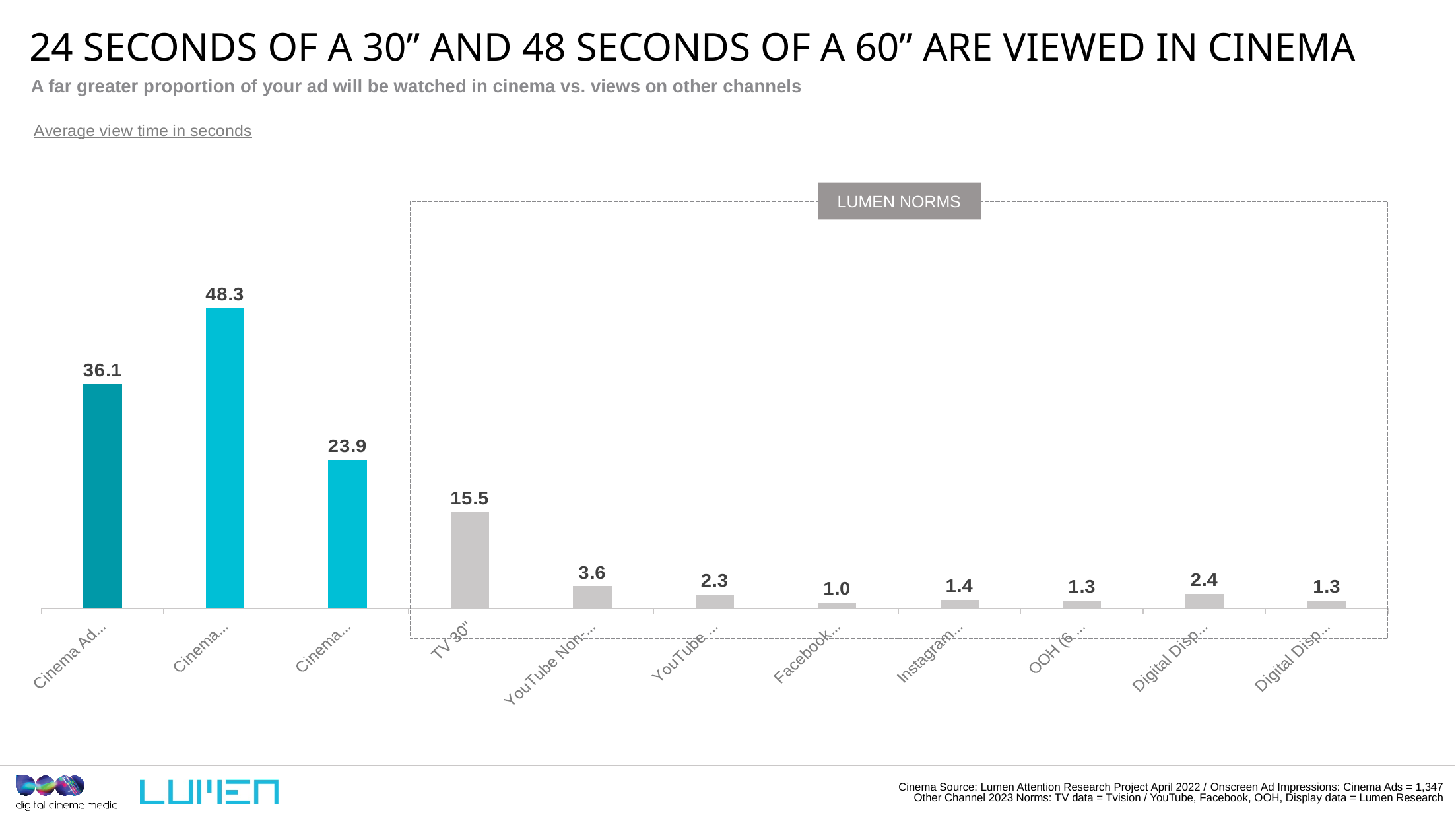
How many bars fall inside the dashed box labelled LUMEN NORMS? 8 What is the difference between the highest bar (48.3) and the TV 30" bar (15.5)? 32.8 What text appears in the grey box above the dashed outline on the right side of the chart? LUMEN NORMS What is the difference between the first bar (36.1) and the third bar (23.9)? 12.2 What is the highest value shown in the chart? 48.3 What value is printed above the third bar in the chart? 23.9 What is the average view time in seconds for TV 30"? 15.5 What kind of chart is shown on the slide? bar chart Which is larger: the value for TV 30" or the value of the third bar from the left? the third bar (23.9) What is the lowest value shown in the chart? 1.0 How many bars are plotted in the chart? 11 What value is printed above the first (leftmost) bar in the chart? 36.1